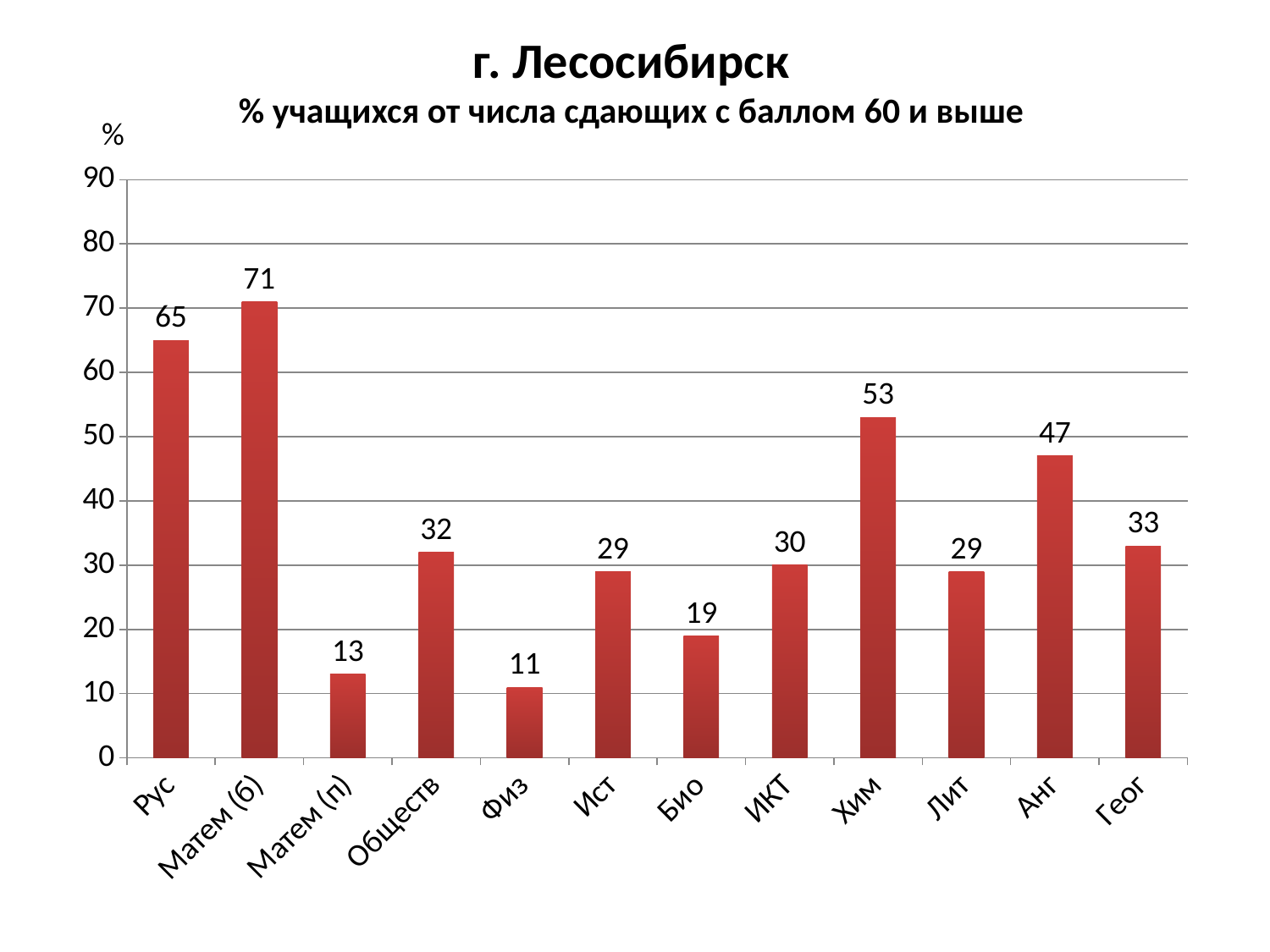
Which category has the highest value? Матем (б) What is the difference between the values for Рус and Матем (п)? 52 Which is larger, the value for Анг or the value for Геог? Анг Is the value for ИКТ greater or less than 40? less What is the difference between the values for Хим and Био? 34 What is the value for Хим? 53 What kind of chart is shown on the slide? bar chart What is the title of the chart? г. Лесосибирск What is the value for Физ? 11 What is the value for Матем (б)? 71 Which category has the lowest value? Физ How many categories are shown on the x axis? 12